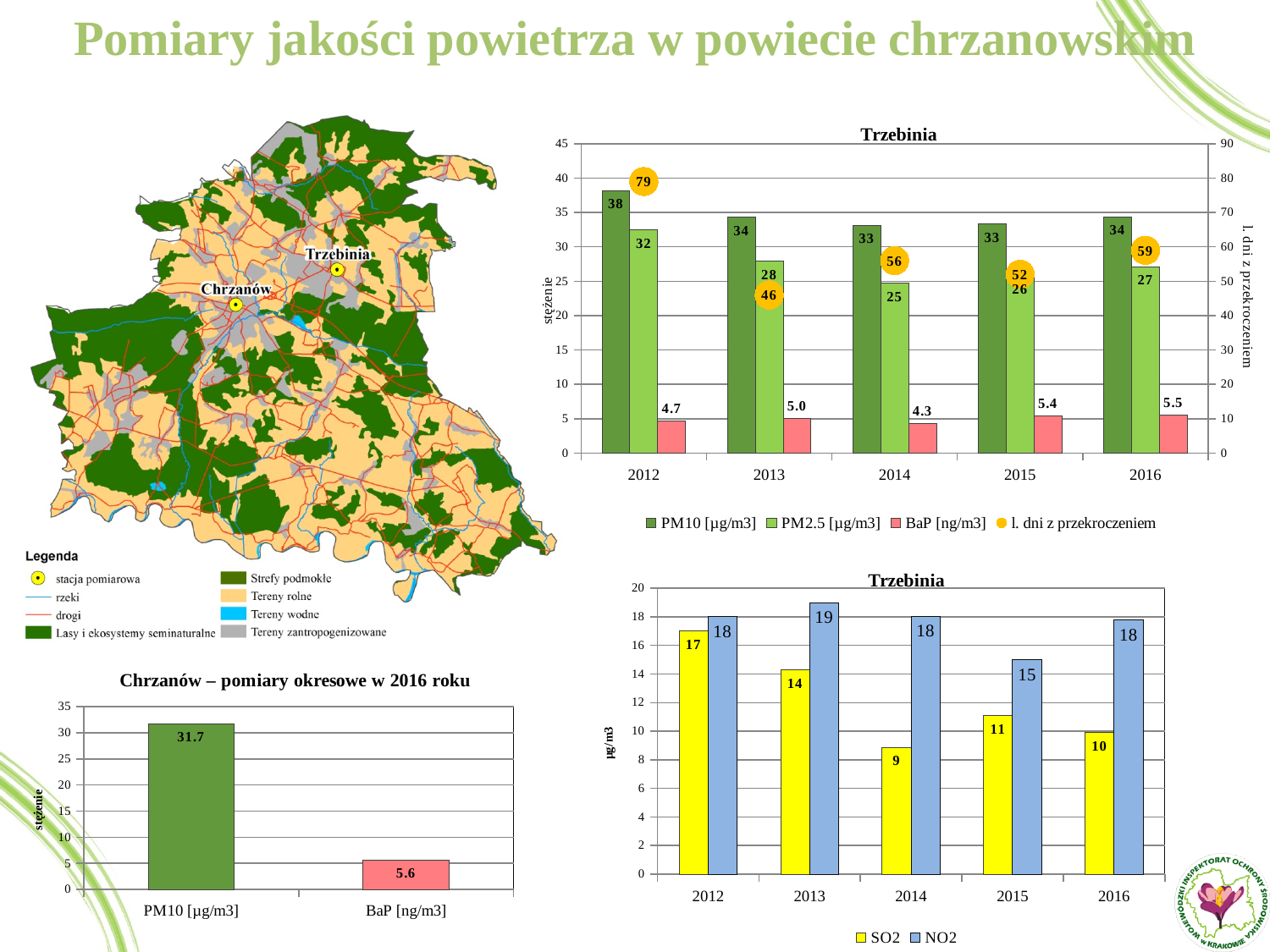
In the bottom-right Trzebinia chart, which year has the lowest SO2 value? 2014 In the bottom-right Trzebinia chart, what is the NO2 value for 2013? 19 How many years are shown on the x axis of the bottom-right Trzebinia chart? 5 In the top-right Trzebinia chart, what is the BaP value for 2016? 5.5 In the chart titled 'Chrzanów – pomiary okresowe w 2016 roku', what is the PM10 value? 31.7 What kind of chart is 'Chrzanów – pomiary okresowe w 2016 roku'? bar chart In the top-right Trzebinia chart, what is the PM10 value for 2012? 38 In the top-right Trzebinia chart, which year has the highest number of days with exceedance (l. dni z przekroczeniem)? 2012 In the top-right Trzebinia chart, what is the difference between the PM2.5 values for 2012 and 2016? 5 How many series does the legend of the top-right Trzebinia chart list? 4 In the top-right Trzebinia chart, which year has the lowest BaP value? 2014 In the bottom-right Trzebinia chart, is the SO2 value for 2012 or the NO2 value for 2012 larger? NO2